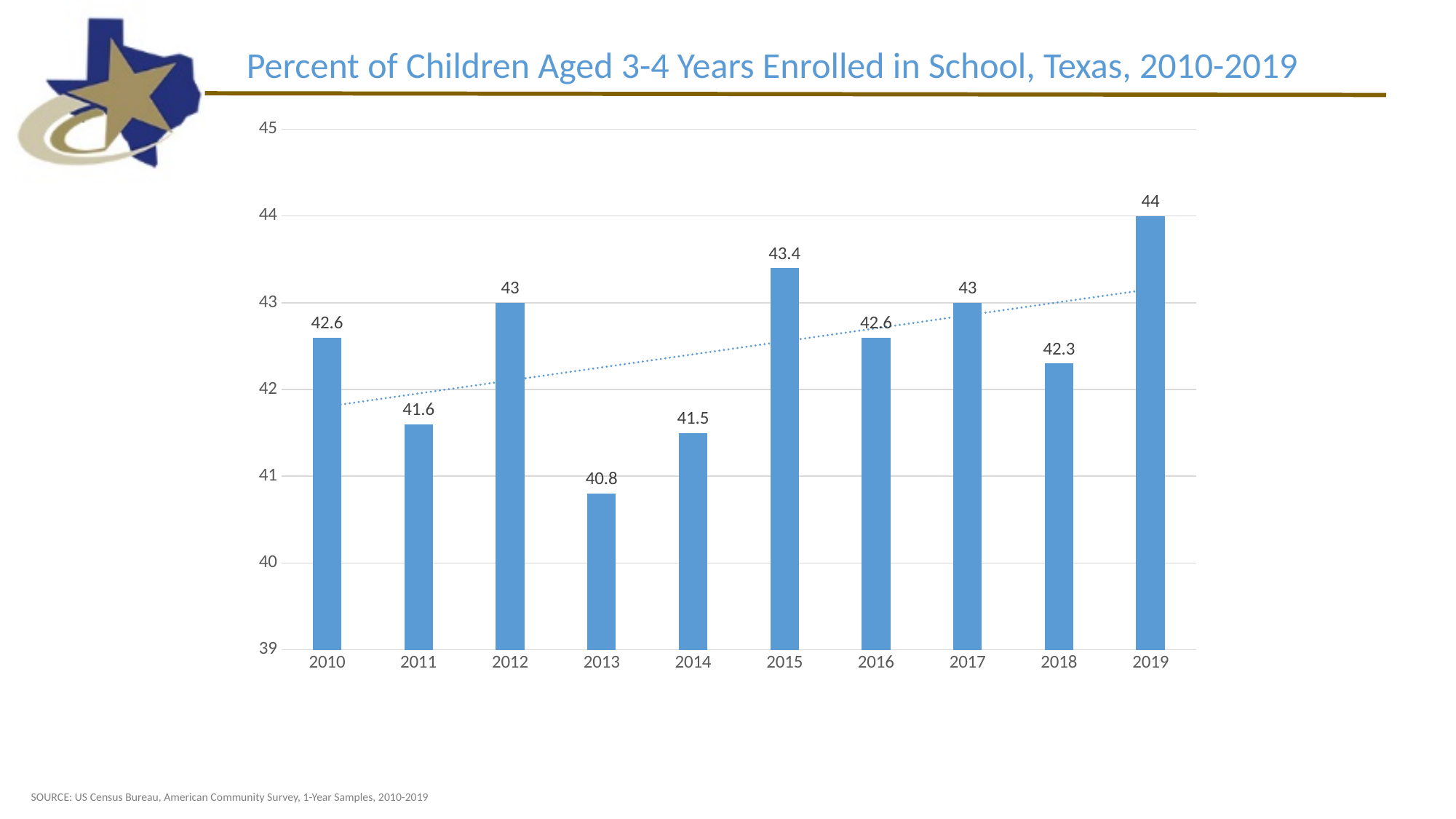
Is the value for 2011 greater or less than 42? less What value is shown for 2013? 40.8 What is the difference between the values for 2019 and 2013? 3.2 Which year has the lowest percent of children aged 3-4 enrolled in school? 2013 What is the percent of children aged 3-4 years enrolled in school in Texas in 2015? 43.4 Which year has the highest percent of children aged 3-4 enrolled in school? 2019 What kind of chart is shown on the slide? bar chart Which year has a larger value, 2012 or 2016? 2012 What is the title of the chart? Percent of Children Aged 3-4 Years Enrolled in School, Texas, 2010-2019 What value is shown for 2018? 42.3 How many years are shown on the x axis? 10 What is the difference between the values for 2015 and 2014? 1.9